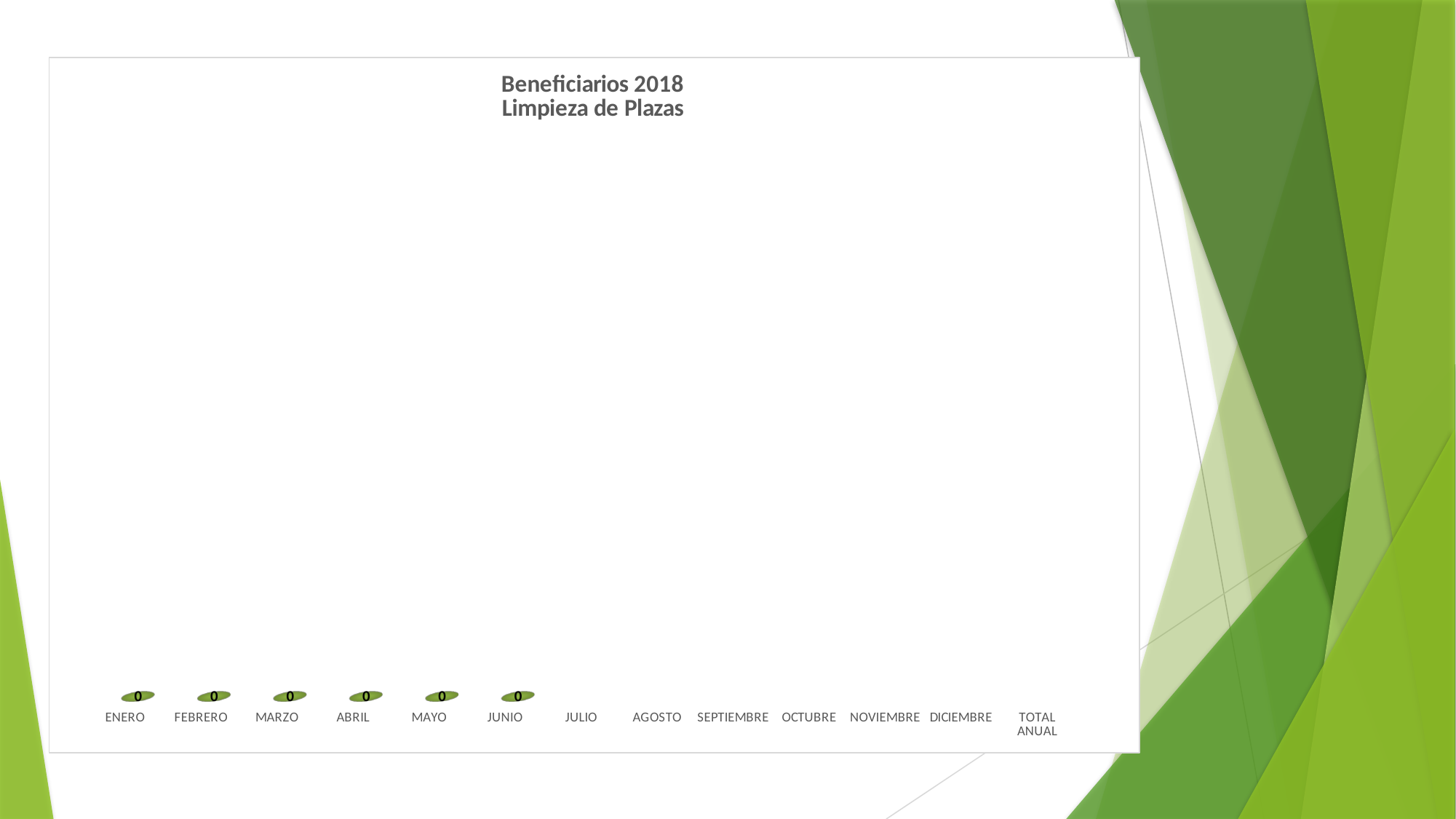
What is the value for MARZO? 0 What is the difference between the values for ENERO and JUNIO? 0 How many categories have a data label printed? 6 What kind of chart is shown? bar chart What is the value for ENERO? 0 What is the title of the chart? Beneficiarios 2018 Limpieza de Plazas What is the value for JUNIO? 0 How many categories are shown on the x axis? 13 Do the values rise, fall, or stay flat from ENERO to JUNIO? stay flat What is the value for MAYO? 0 What is the value for ABRIL? 0 What is the value for FEBRERO? 0